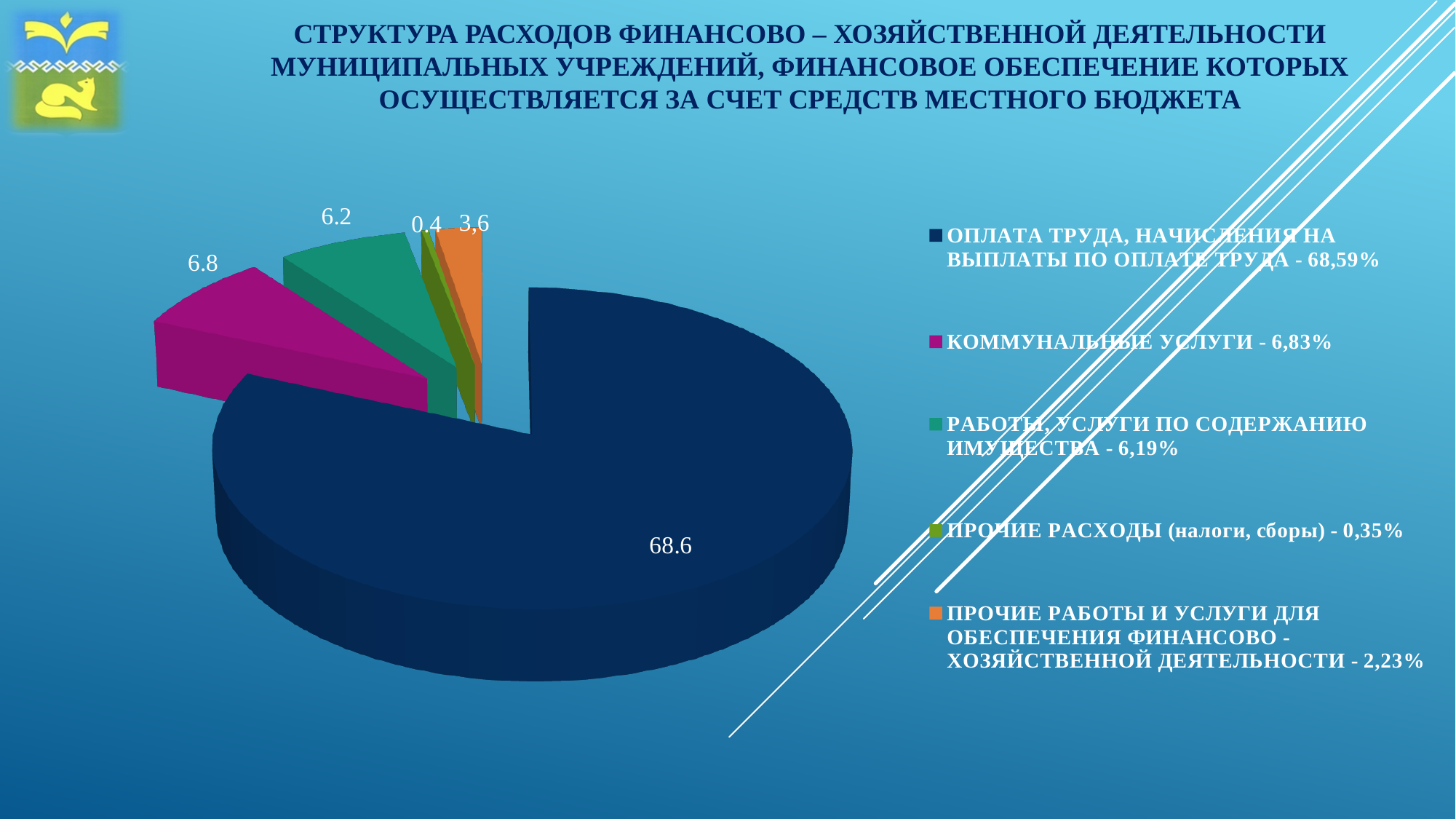
What is the data label on the slice for РАБОТЫ, УСЛУГИ ПО СОДЕРЖАНИЮ ИМУЩЕСТВА? 6.2 Which category has the smallest slice of the pie? ПРОЧИЕ РАСХОДЫ (налоги, сборы) What is the data label on the slice for КОММУНАЛЬНЫЕ УСЛУГИ? 6.8 What is the difference between the data labels for КОММУНАЛЬНЫЕ УСЛУГИ and РАБОТЫ, УСЛУГИ ПО СОДЕРЖАНИЮ ИМУЩЕСТВА? 0.6 How many slices does the pie chart have? 5 What percentage does the legend give for КОММУНАЛЬНЫЕ УСЛУГИ? 6,83% Which slice is larger, КОММУНАЛЬНЫЕ УСЛУГИ or РАБОТЫ, УСЛУГИ ПО СОДЕРЖАНИЮ ИМУЩЕСТВА? КОММУНАЛЬНЫЕ УСЛУГИ What kind of chart is shown on the slide? pie chart Which category has the largest slice of the pie? ОПЛАТА ТРУДА, НАЧИСЛЕНИЯ НА ВЫПЛАТЫ ПО ОПЛАТЕ ТРУДА How many entries does the legend list? 5 What is the data label on the slice for ПРОЧИЕ РАСХОДЫ (налоги, сборы)? 0.4 What is the data label on the slice for ОПЛАТА ТРУДА, НАЧИСЛЕНИЯ НА ВЫПЛАТЫ ПО ОПЛАТЕ ТРУДА? 68.6